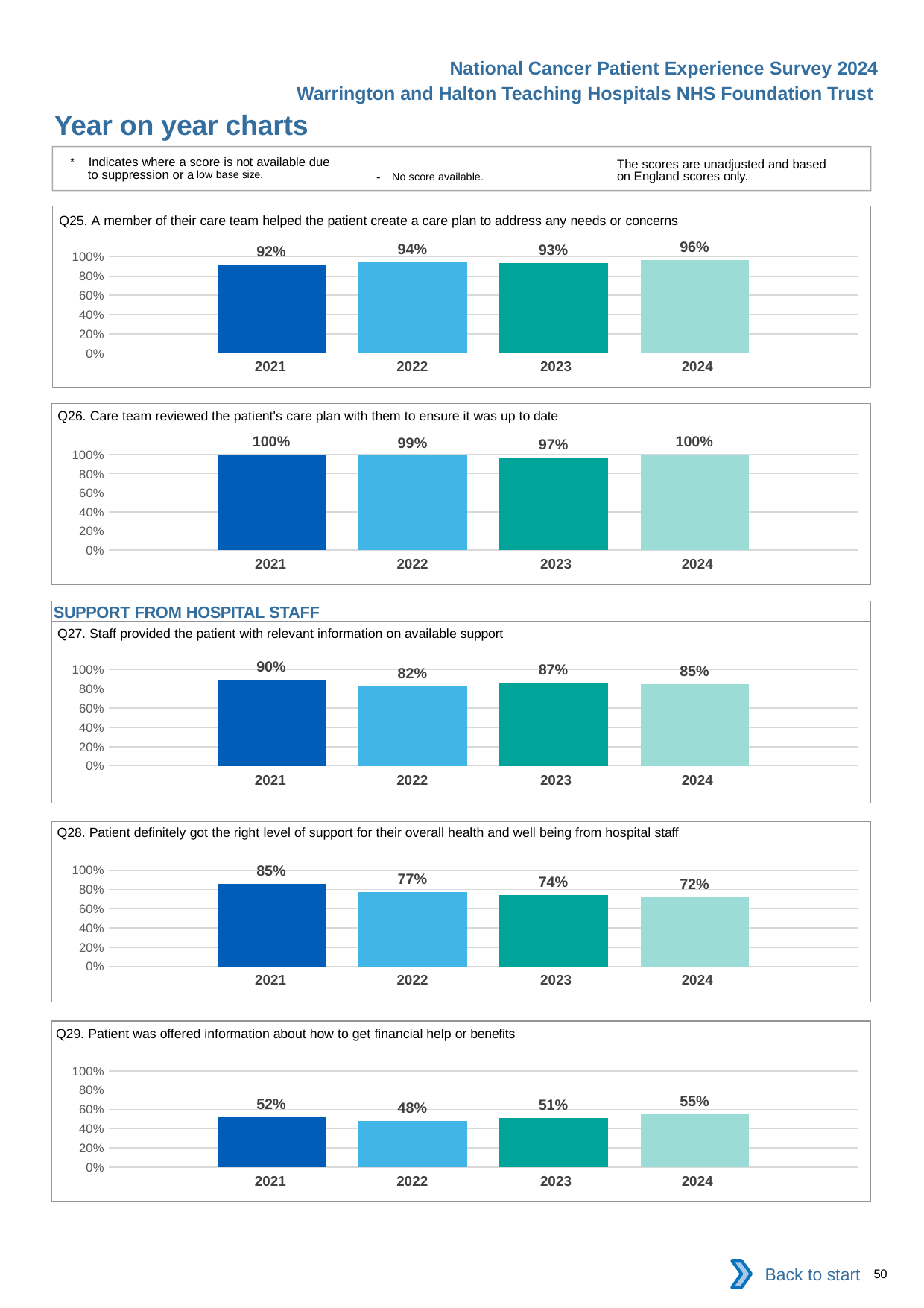
In the Q26 chart, what is the value for 2022? 99% In the Q29 chart, is the value for 2022 greater or less than 50%? less How many years are shown in the Q25 chart? 4 In the Q27 chart, what is the difference between the 2021 and 2022 values? 8% What kind of chart is the Q27 chart? bar chart In the Q29 chart, which year has the highest value? 2024 In the Q28 chart, do the values rise or fall from 2021 to 2024? fall In the Q28 chart, which is larger, the value for 2022 or the value for 2024? 2022 In the Q26 chart, which year has the lowest value? 2023 In the Q25 chart, what is the value for 2024? 96% In the Q28 chart, what is the difference between the 2021 and 2024 values? 13% What is the section heading shown above the Q27 chart? SUPPORT FROM HOSPITAL STAFF